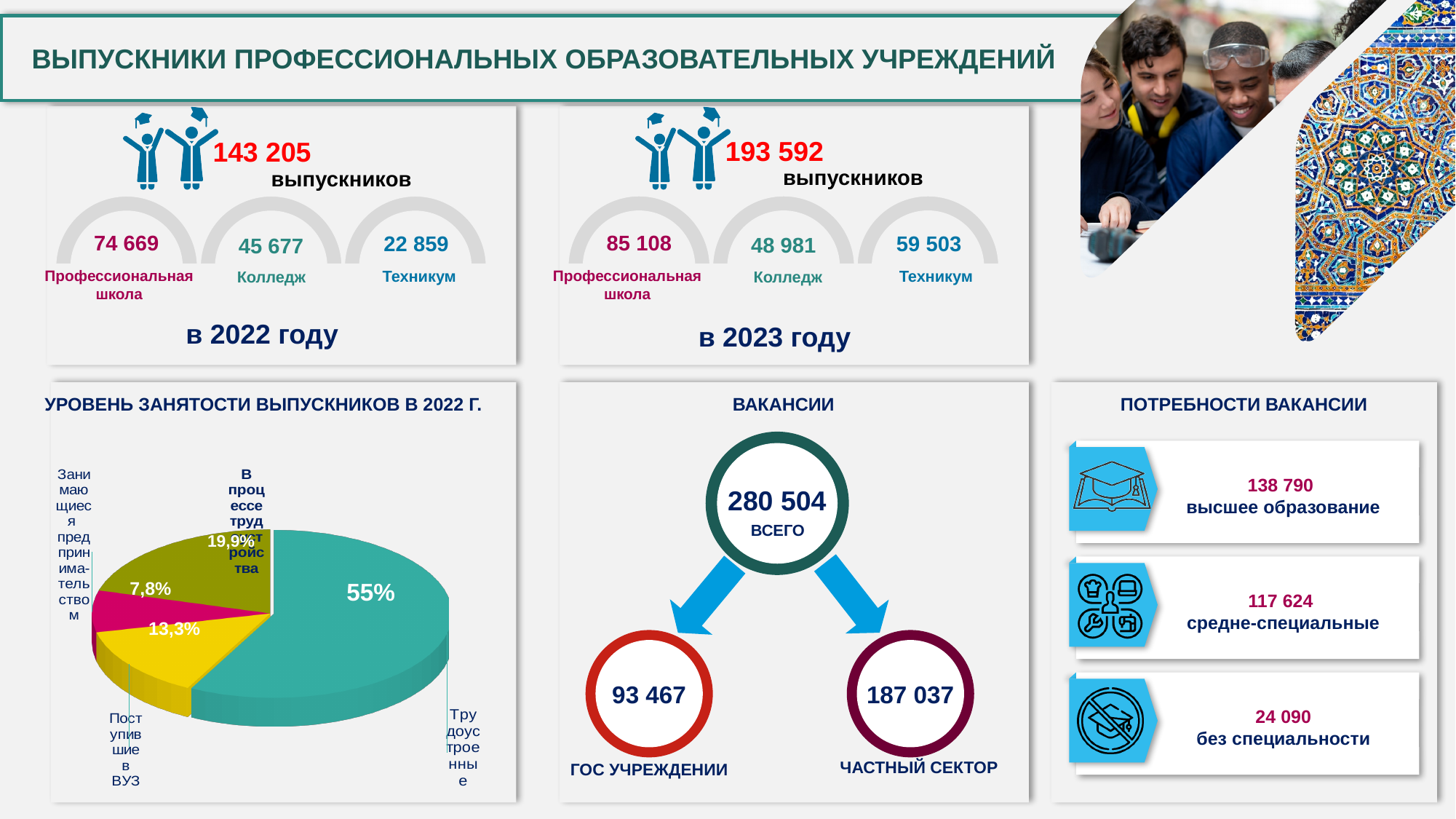
In the pie chart, which is larger: 'Поступившие в ВУЗ' or 'В процессе трудоустройства'? В процессе трудоустройства In the pie chart, what share is labelled for 'В процессе трудоустройства'? 19,9% In the pie chart, what share is labelled for 'Трудоустроенные'? 55% How many slices does the pie chart 'УРОВЕНЬ ЗАНЯТОСТИ ВЫПУСКНИКОВ В 2022 Г.' have? 4 What kind of chart is shown under the title 'УРОВЕНЬ ЗАНЯТОСТИ ВЫПУСКНИКОВ В 2022 Г.'? Pie chart Which slice of the pie chart is the largest? Трудоустроенные In the pie chart, what share is labelled for 'Занимающиеся предпринимательством'? 7,8% In the pie chart, what is the difference between the 'Трудоустроенные' share and the 'В процессе трудоустройства' share? 35,1% Which slice of the pie chart is the smallest? Занимающиеся предпринимательством In the pie chart, what share is labelled for 'Поступившие в ВУЗ'? 13,3% What is the title of the pie chart on the slide? УРОВЕНЬ ЗАНЯТОСТИ ВЫПУСКНИКОВ В 2022 Г. In the pie chart, what colour is the 'Трудоустроенные' slice? Teal